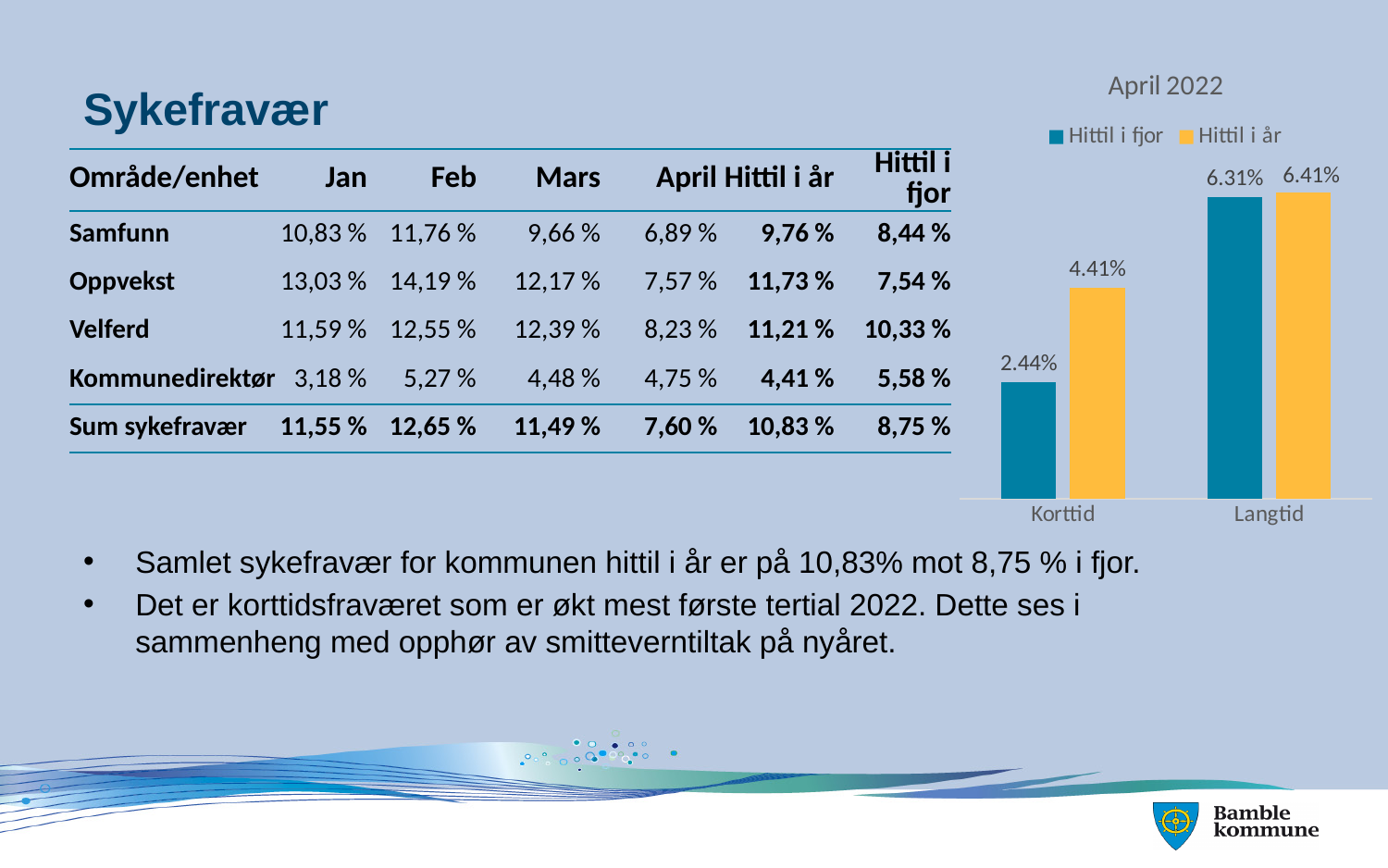
Which category has the highest 'Hittil i år' value? Langtid What is the value of 'Hittil i fjor' for Korttid? 2.44% Which series is shown in yellow in the chart? Hittil i år How many series does the chart legend list? 2 What is the value of 'Hittil i fjor' for Langtid? 6.31% Which category has the lowest 'Hittil i fjor' value? Korttid What type of chart is shown on the slide? bar chart What is the difference between 'Hittil i år' and 'Hittil i fjor' for Korttid? 1.97% What is the value of 'Hittil i år' for Korttid? 4.41% What is the title of the chart? April 2022 What is the value of 'Hittil i år' for Langtid? 6.41% How many categories are shown on the x axis of the chart? 2